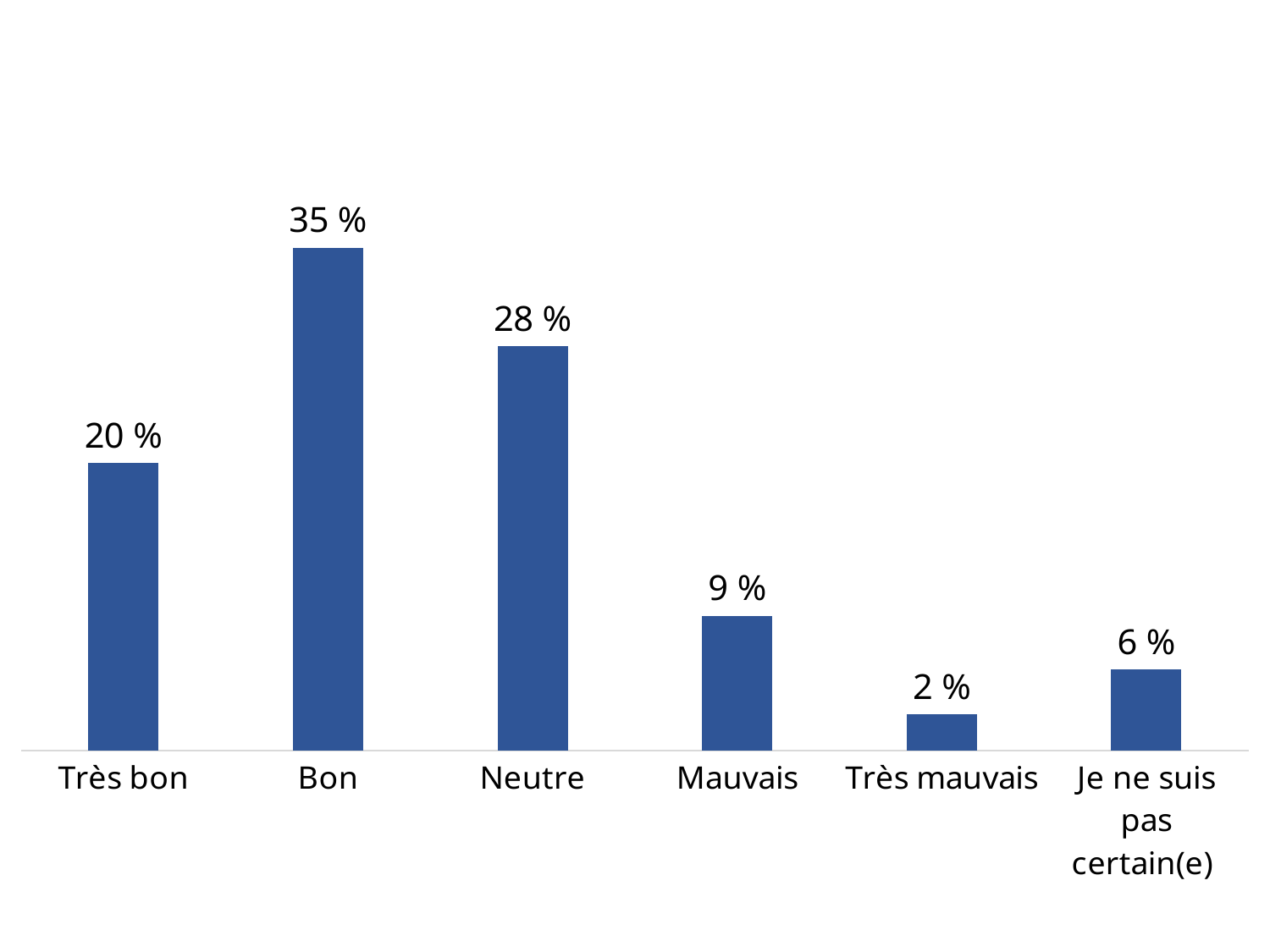
How many categories are shown on the x axis? 6 What is the value for Très bon? 20 % Which category has the highest value? Bon What kind of chart is this? Bar chart What is the value for Je ne suis pas certain(e)? 6 % What is the value for Neutre? 28 % What is the difference between the values for Bon and Neutre? 7 % What is the value for Bon? 35 % What is the difference between the values for Mauvais and Très mauvais? 7 % Which category has the lowest value? Très mauvais Which is larger, the value for Très bon or the value for Mauvais? Très bon What colour are the bars? Blue